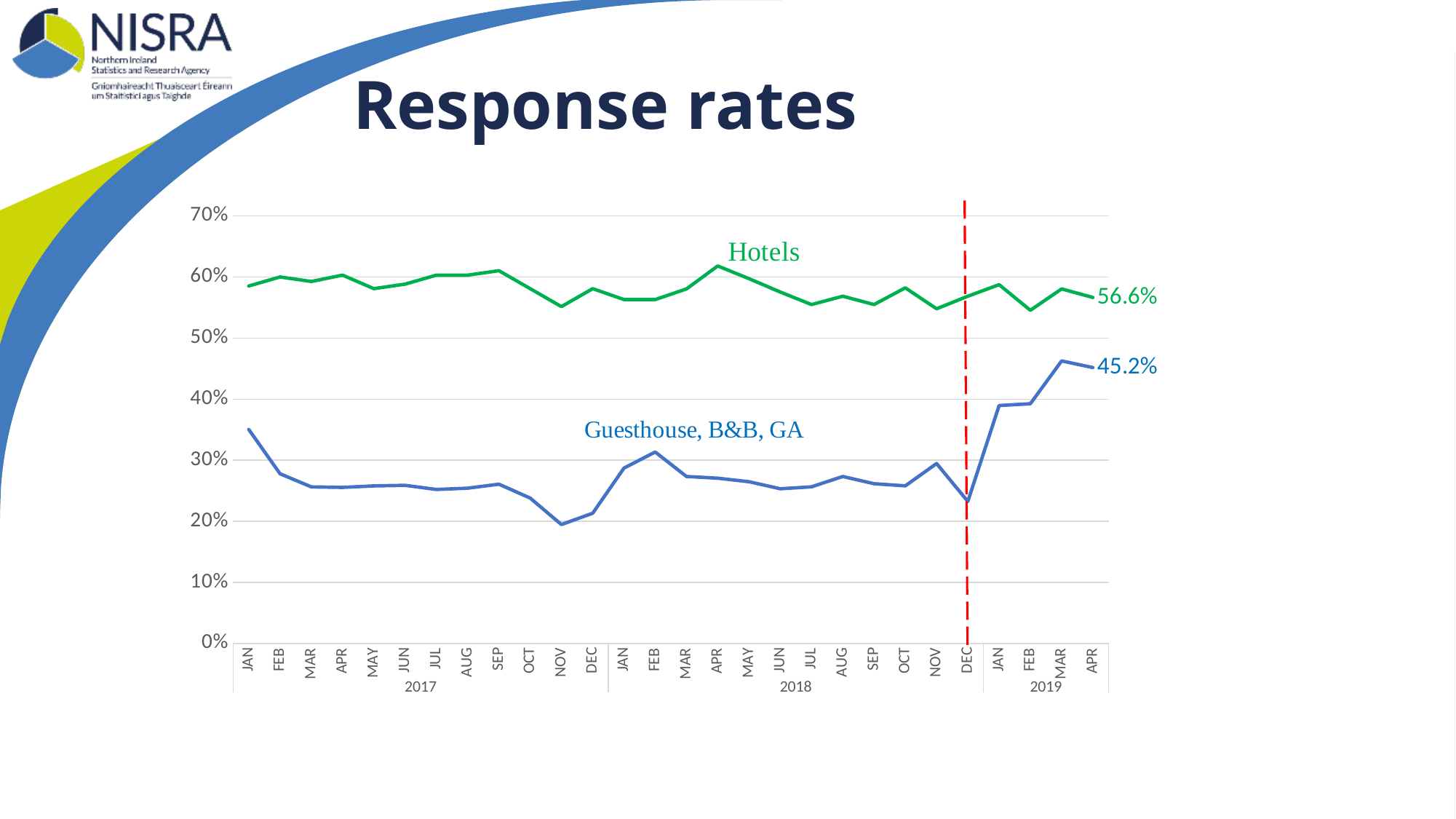
Is the Guesthouse, B&B, GA value for DEC 2018 greater or less than 30%? less What is the response rate for Guesthouse, B&B, GA in APR 2019? 45.2% Is the Guesthouse, B&B, GA value for JAN 2017 greater or less than 30%? greater What is the title of the chart on the slide? Response rates Does the Guesthouse, B&B, GA response rate rise or fall from DEC 2018 to MAR 2019? rise How many monthly data points are plotted along the x axis? 28 In which month is the Guesthouse, B&B, GA response rate highest? MAR 2019 What is the response rate for Hotels in APR 2019? 56.6% What is the difference between the Hotels and Guesthouse, B&B, GA response rates in APR 2019? 11.4% Which series has the higher response rate in APR 2019, Hotels or Guesthouse, B&B, GA? Hotels How many series are plotted on the chart? 2 What kind of chart is shown on the slide? line chart